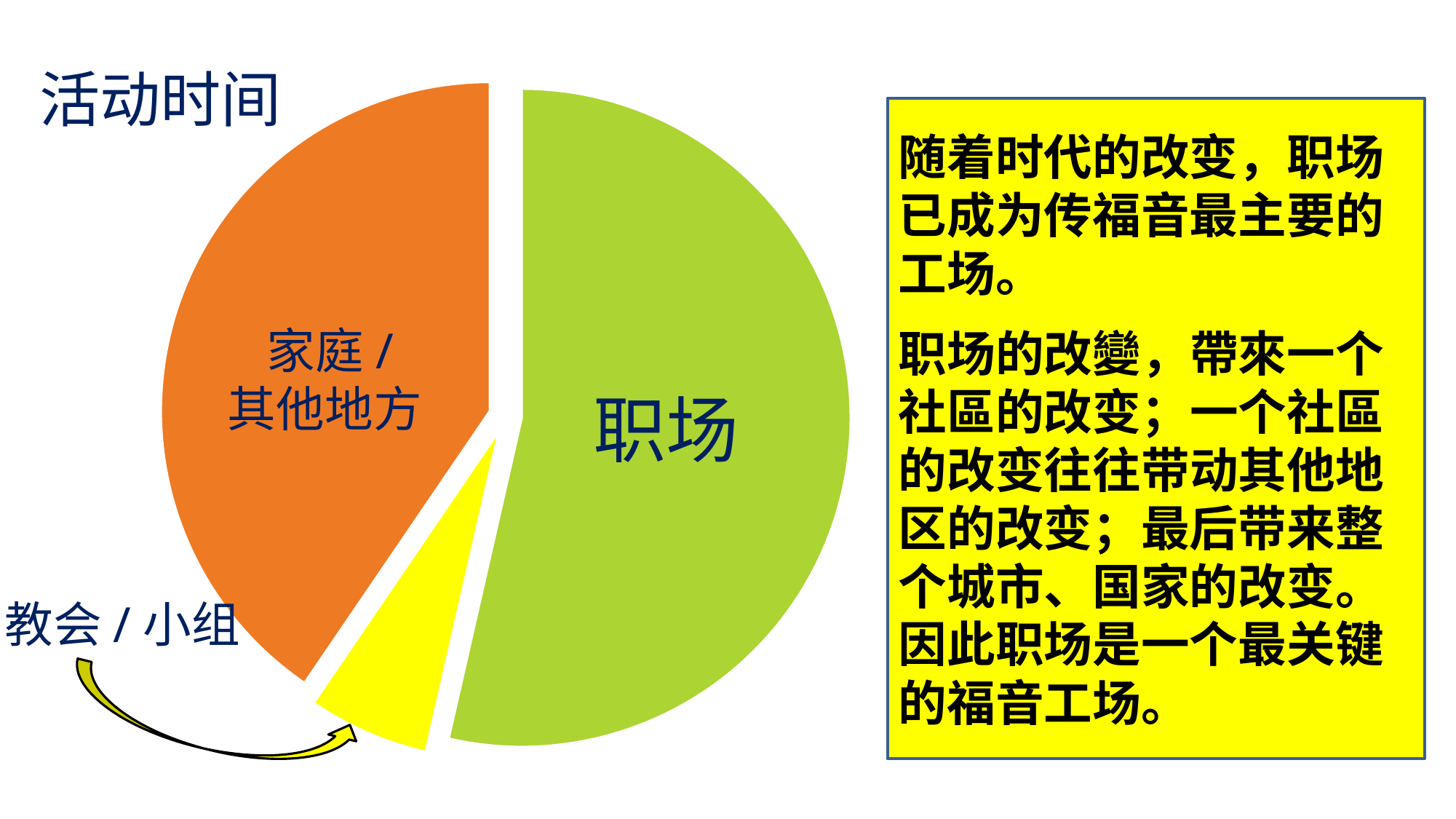
How many slices does the pie chart have? 3 What colour is the 职场 slice of the pie chart? green What kind of chart is shown on the slide? pie chart Which slice is larger, 职场 or 家庭 / 其他地方? 职场 Which category does the yellow slice of the pie chart represent? 教会 / 小组 Which slice is larger, 家庭 / 其他地方 or 教会 / 小组? 家庭 / 其他地方 Which category does the orange slice of the pie chart represent? 家庭 / 其他地方 Which category has the largest slice of the pie chart? 职场 What is the title of the pie chart? 活动时间 Which category has the smallest slice of the pie chart? 教会 / 小组